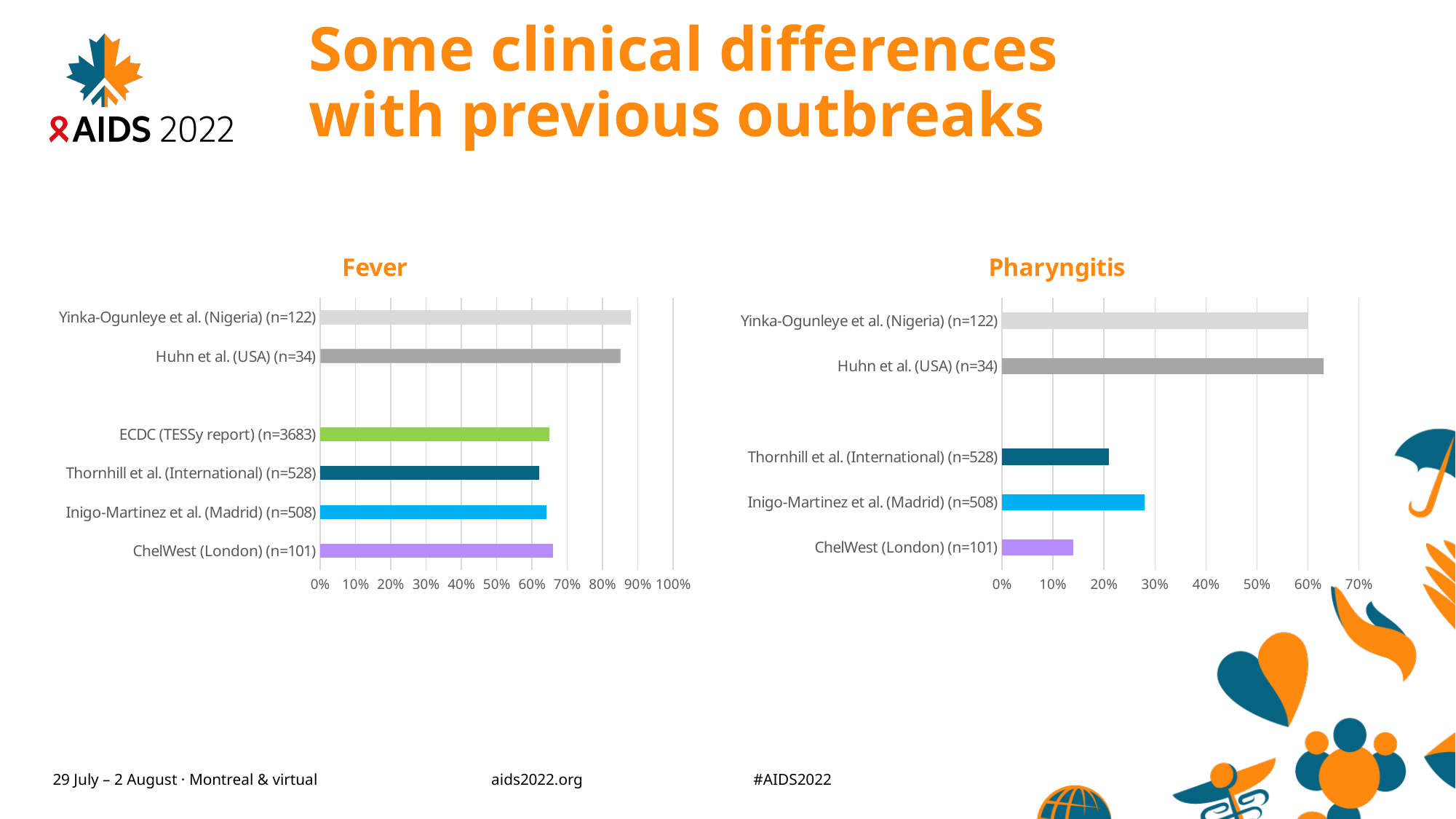
In the Pharyngitis chart, which is larger: Inigo-Martinez et al. (Madrid) (n=508) or ChelWest (London) (n=101)? Inigo-Martinez et al. (Madrid) (n=508) In the Pharyngitis chart, is the value for Yinka-Ogunleye et al. (Nigeria) (n=122) greater or less than 50%? greater In the Pharyngitis chart, is the value for Inigo-Martinez et al. (Madrid) (n=508) greater or less than 30%? less What are the titles of the two charts on the slide? Fever and Pharyngitis In the Pharyngitis chart, which category has the lowest value? ChelWest (London) (n=101) How many categories are plotted in the Fever chart? 6 In the Pharyngitis chart, is the value for ChelWest (London) (n=101) greater or less than 20%? less What kind of chart is the Fever chart? bar chart In the Fever chart, which is larger: Huhn et al. (USA) (n=34) or ECDC (TESSy report) (n=3683)? Huhn et al. (USA) (n=34) How many categories are plotted in the Pharyngitis chart? 5